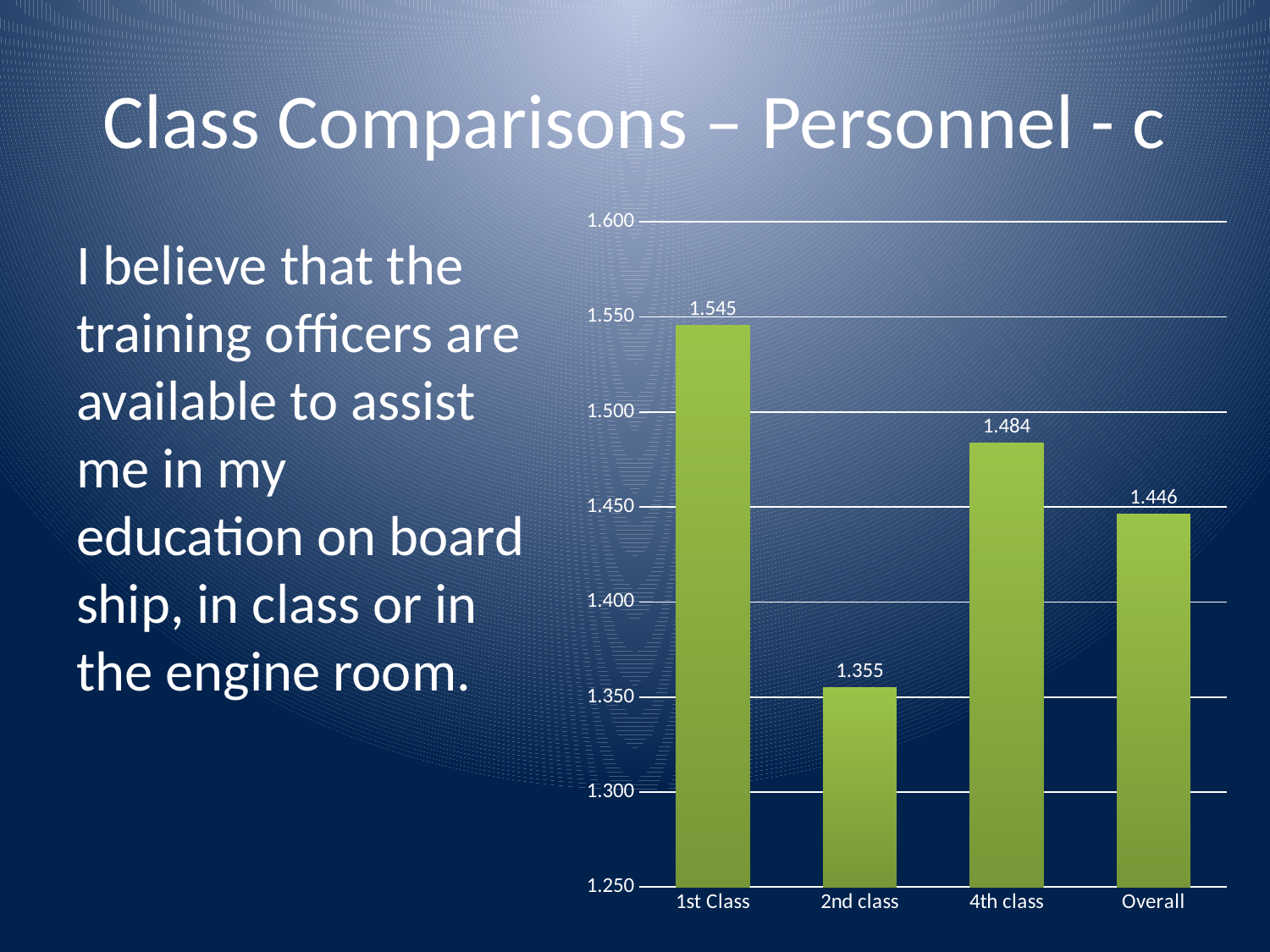
What is the value for Overall? 1.446 What is the difference between the values for 4th class and Overall? 0.038 Is the value for 2nd class greater or less than 1.400? less What is the value for 2nd class? 1.355 What is the value for 1st Class? 1.545 What is the value for 4th class? 1.484 What is the difference between the values for 1st Class and 2nd class? 0.190 How many categories are shown on the x axis? 4 Which is larger, the value for 4th class or the value for Overall? 4th class Which category has the lowest value? 2nd class Which category has the highest value? 1st Class What kind of chart is shown on the slide? bar chart